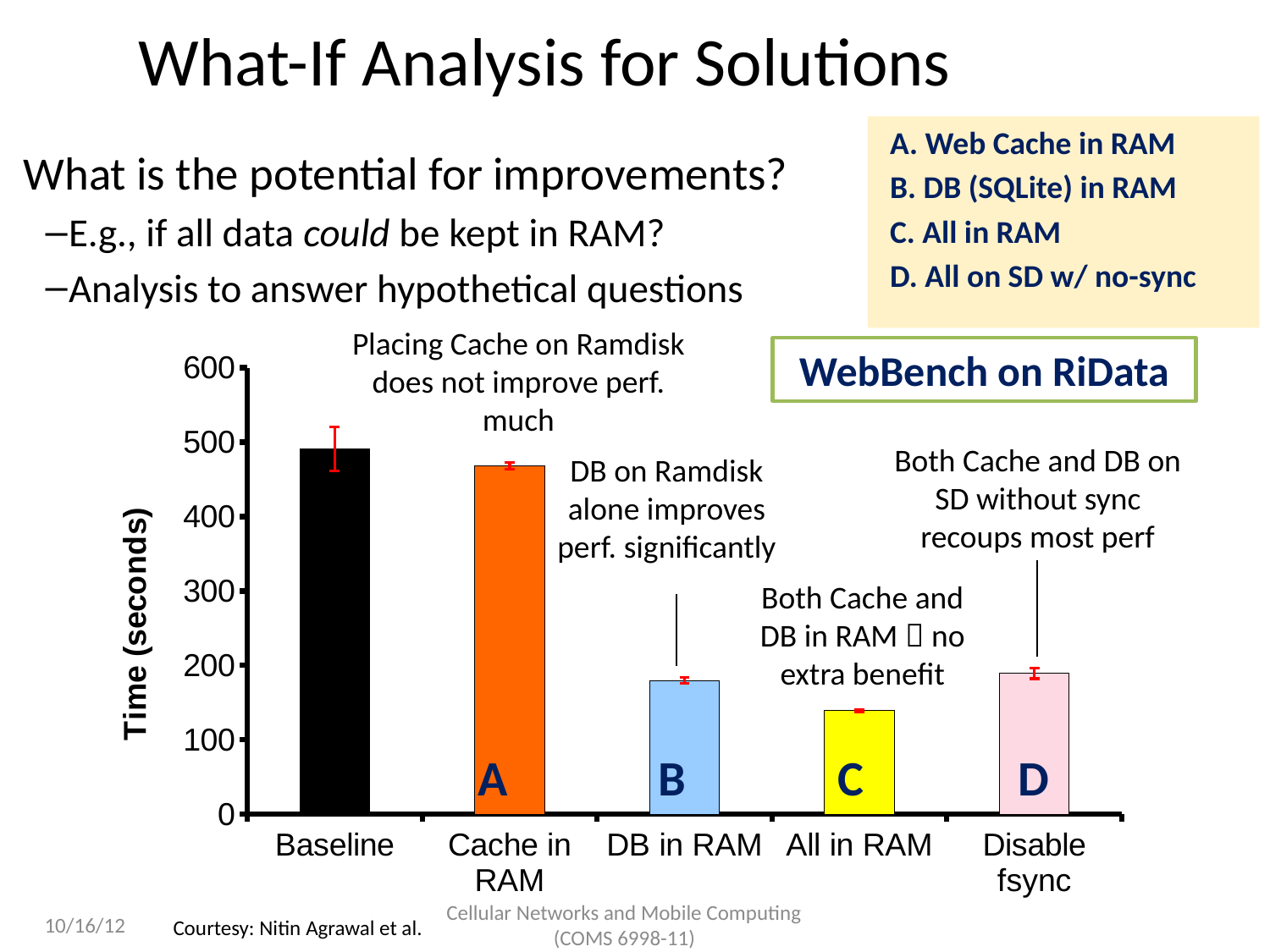
What title is shown in the box above the chart? WebBench on RiData Is the value for DB in RAM greater or less than 300? less Is the value for Cache in RAM greater or less than 400? greater Which is larger, the value for Baseline or the value for Disable fsync? Baseline Which is larger, the value for DB in RAM or the value for All in RAM? DB in RAM Is the value for Disable fsync greater or less than 300? less What kind of chart is shown on the slide? bar chart What is the label of the y axis of the chart? Time (seconds) How many categories are plotted on the x axis of the chart? 5 Which category has the lowest bar in the chart? All in RAM